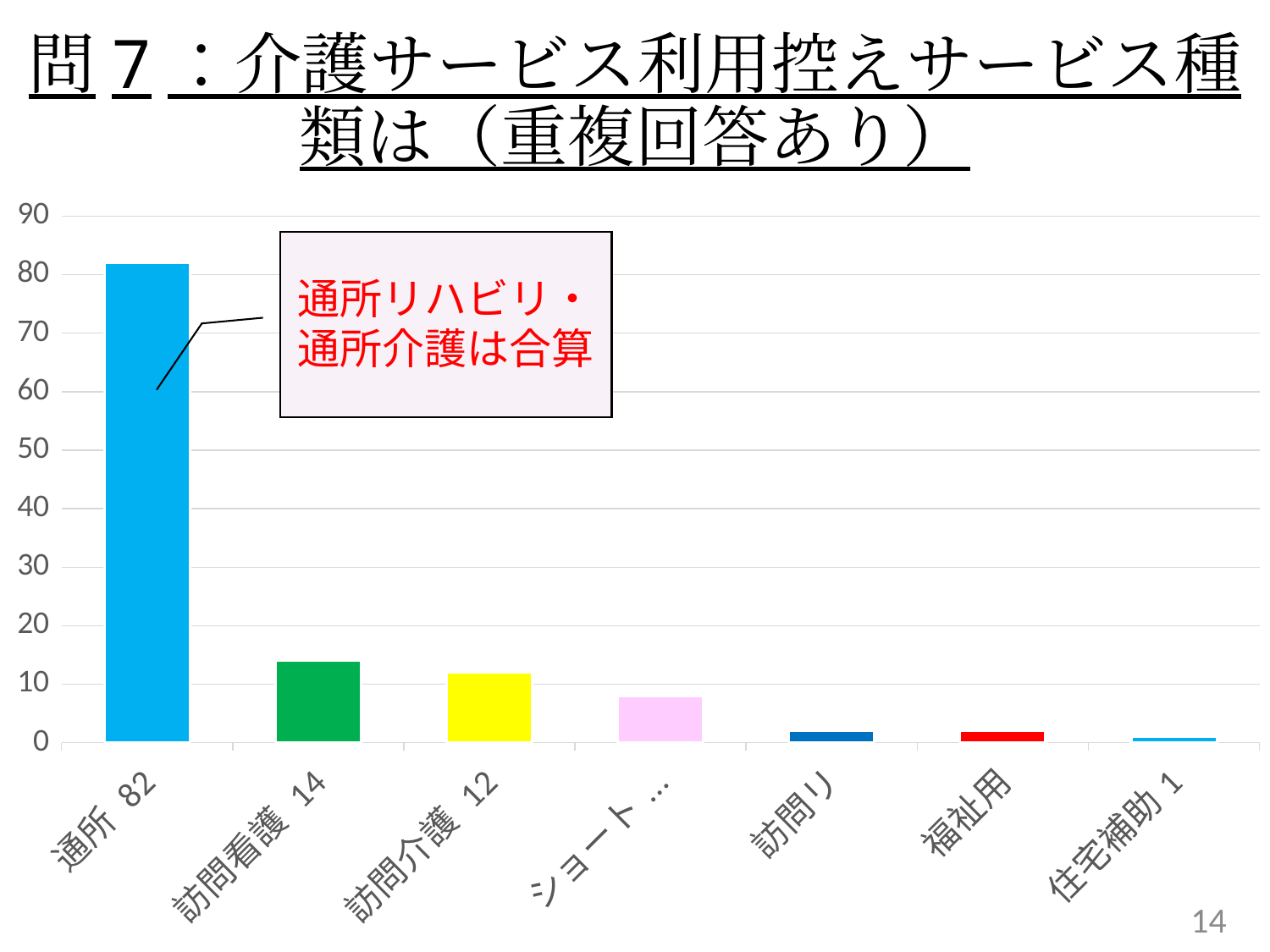
What does the red callout text on the chart say? 通所リハビリ・通所介護は合算 What is the difference between the values for 通所 and 訪問看護? 68 Which category has the lowest value? 住宅補助 What is the value for 通所? 82 Is the value for ショート… greater or less than 10? less How many categories are shown in the chart? 7 Which is larger, the value for 訪問看護 or the value for 訪問介護? 訪問看護 What is the value for 訪問介護? 12 What kind of chart is shown on the slide? bar chart What is the value for 住宅補助? 1 Which category has the highest value? 通所 What is the value for 訪問看護? 14